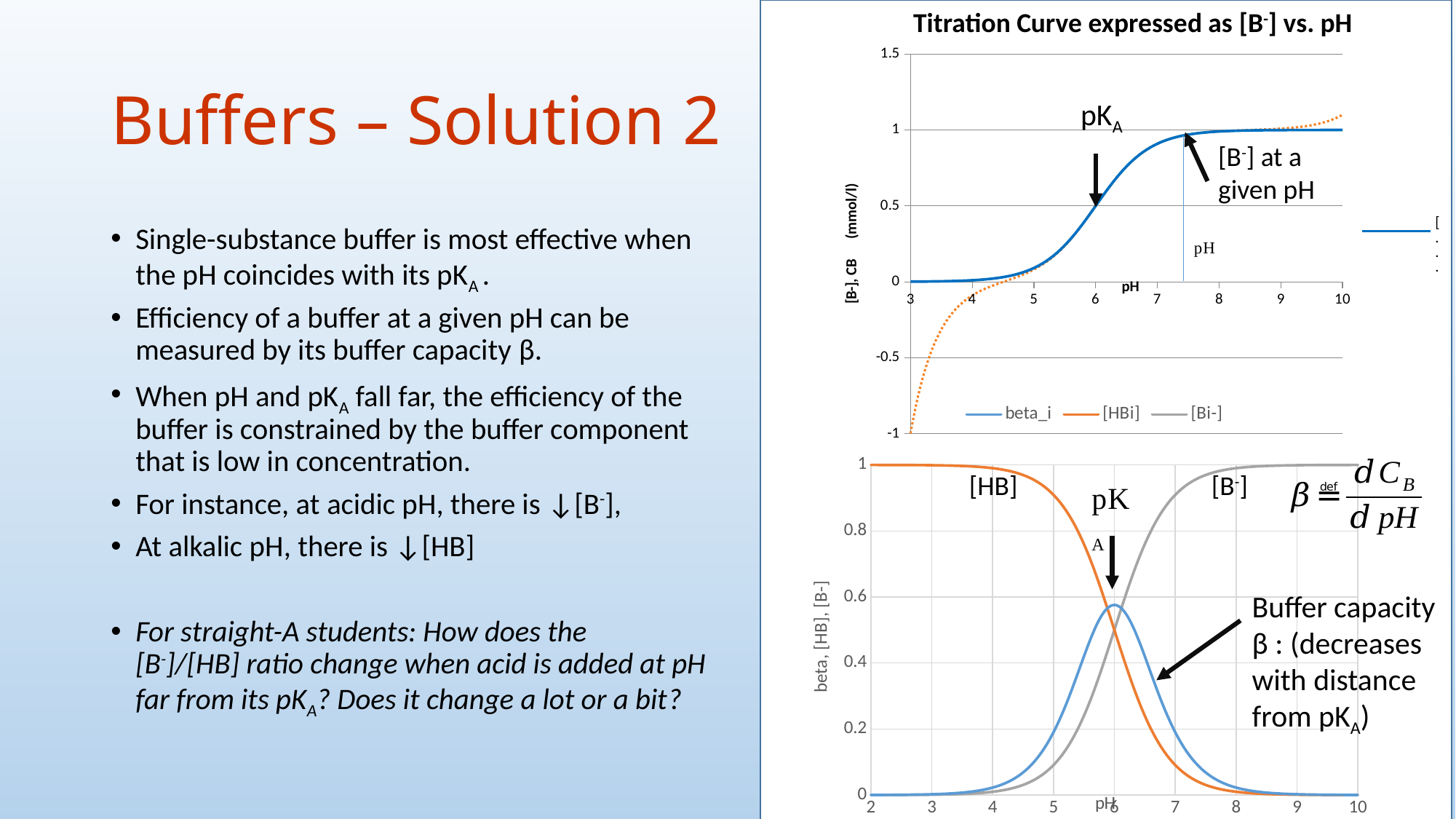
In the bottom chart, is the value of the gray [Bi-] curve at pH 3 greater or less than 0.2? less In the top chart, does the solid blue [B-] curve rise or fall as pH increases? rise In the top chart, is the value of the solid blue curve at pH 9 greater or less than 0.5? greater In the bottom chart, what are the legend entries? beta_i, [HBi], [Bi-] What kind of chart is the top chart, 'Titration Curve expressed as [B-] vs. pH'? line chart In the bottom chart, does the orange [HBi] curve rise or fall as pH increases? fall In the bottom chart, does the gray [Bi-] curve rise or fall as pH increases? rise In the bottom chart, at pH 4, which series has the higher value, [HBi] or [Bi-]? [HBi] In the bottom chart, how many series does the legend list? 3 What is the title of the chart at the top right of the slide? Titration Curve expressed as [B-] vs. pH In the bottom chart, is the peak value of the blue beta_i curve greater or less than 0.5? greater What kind of chart is the bottom chart on the slide? line chart